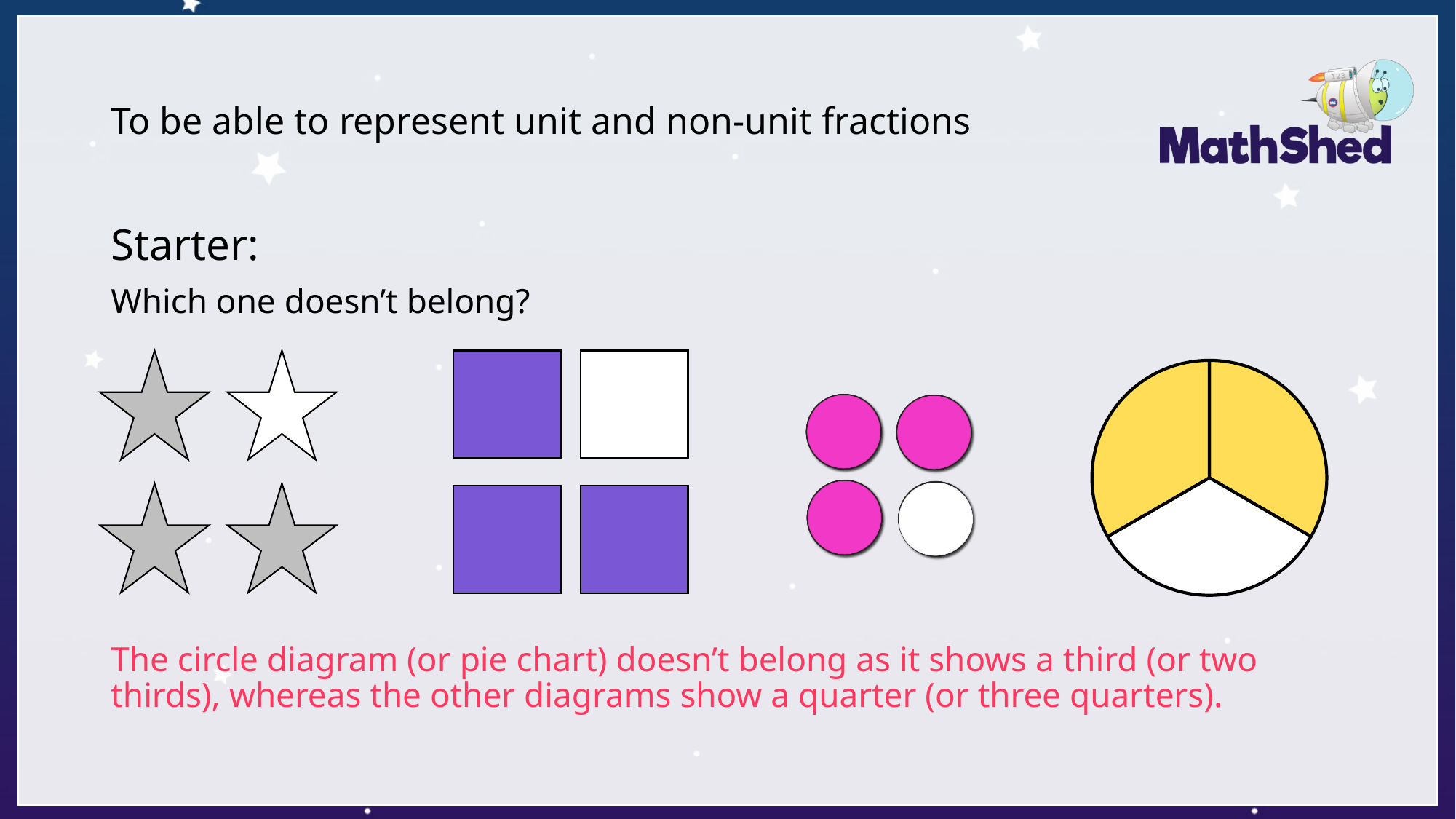
How many slices of the pie chart are shaded yellow? 2 What fraction of the pie chart is left white? a third What kind of chart is shown on the right of the slide? pie chart What fraction of the pie chart is shaded yellow? two thirds Are the slices of the pie chart equal in size? yes According to the slide, which diagram doesn't belong? the circle diagram (or pie chart) Which colour covers the larger share of the pie chart, yellow or white? yellow How many slices is the pie chart divided into? 3